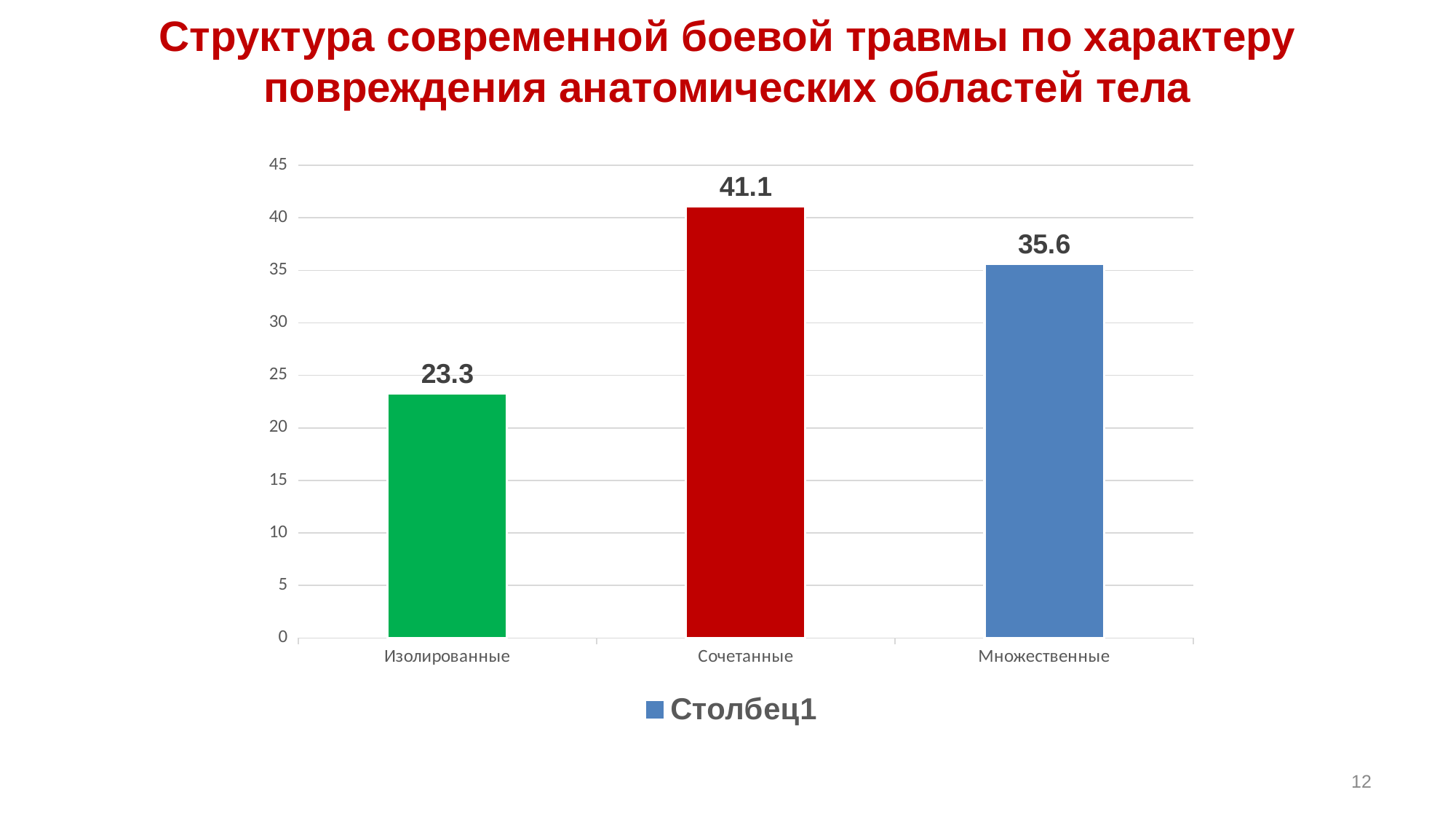
What is the value for Изолированные? 23.3 What is the difference between the values for Множественные and Изолированные? 12.3 What is the value for Сочетанные? 41.1 What is the difference between the values for Сочетанные and Множественные? 5.5 How many categories are shown on the x axis? 3 Is the value for Сочетанные greater or less than 40? greater Which is larger, the value for Изолированные or the value for Множественные? Множественные Which category has the highest value? Сочетанные What is the value for Множественные? 35.6 What kind of chart is shown on the slide? bar chart Which category has the lowest value? Изолированные What series name does the legend show? Столбец1